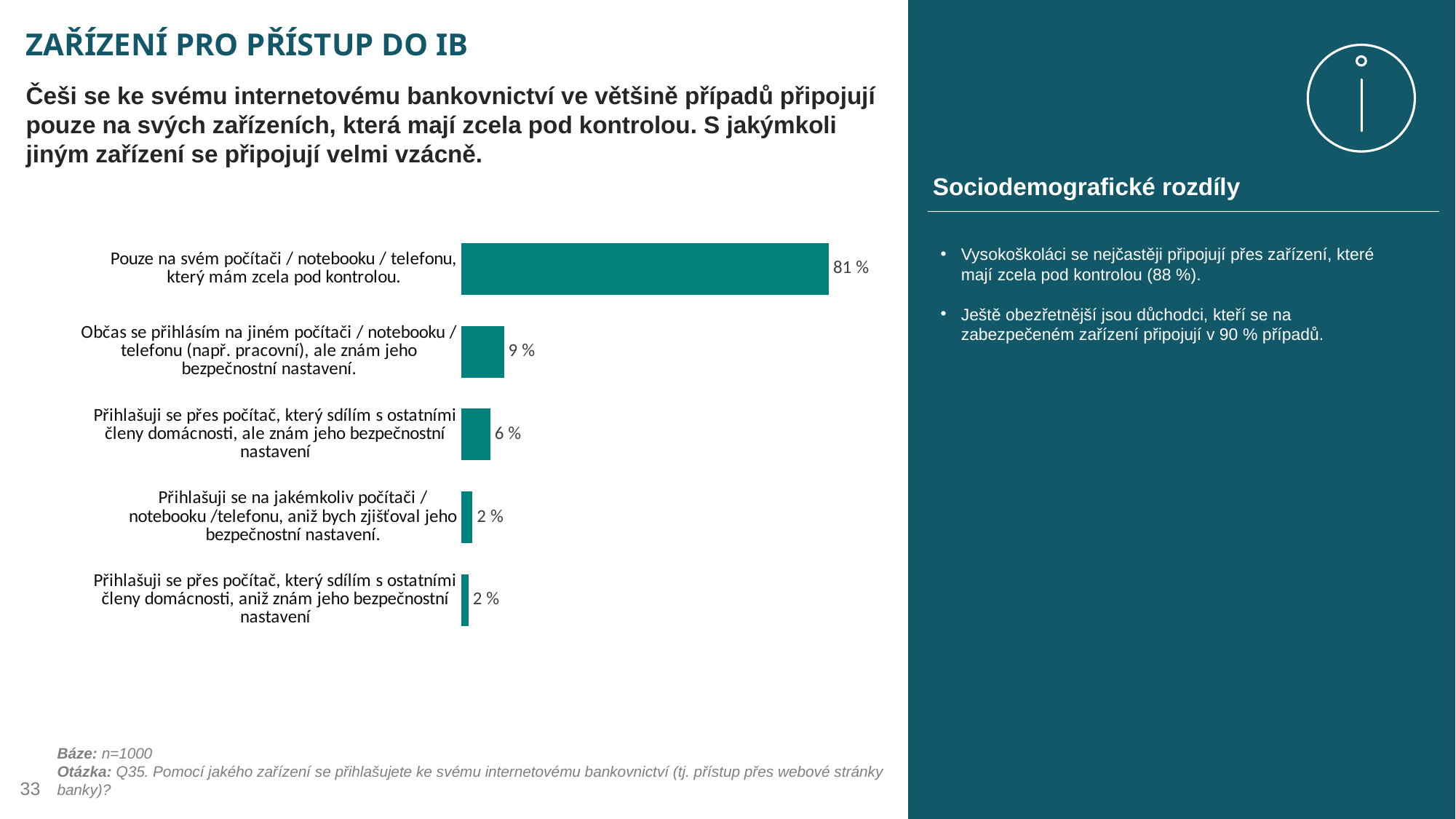
What is the value for "Přihlašuji se na jakémkoliv počítači / notebooku /telefonu, aniž bych zjišťoval jeho bezpečnostní nastavení."? 2 % Which category has the highest value in the chart? Pouze na svém počítači / notebooku / telefonu, který mám zcela pod kontrolou. What is the value for "Pouze na svém počítači / notebooku / telefonu, který mám zcela pod kontrolou."? 81 % What is the difference between the value for "Pouze na svém počítači / notebooku / telefonu, který mám zcela pod kontrolou." and the value for "Občas se přihlásím na jiném počítači / notebooku / telefonu (např. pracovní), ale znám jeho bezpečnostní nastavení."? 72 % What is the value for "Přihlašuji se přes počítač, který sdílím s ostatními členy domácnosti, ale znám jeho bezpečnostní nastavení"? 6 % How many categories (bars) does the chart show? 5 What is the title of the slide containing the chart? ZAŘÍZENÍ PRO PŘÍSTUP DO IB What is the lowest value shown in the chart? 2 % How many categories in the chart have a value of 2 %? 2 Which is larger: the value for "Občas se přihlásím na jiném počítači / notebooku / telefonu (např. pracovní), ale znám jeho bezpečnostní nastavení." or the value for "Přihlašuji se přes počítač, který sdílím s ostatními členy domácnosti, ale znám jeho bezpečnostní nastavení"? Občas se přihlásím na jiném počítači / notebooku / telefonu (např. pracovní), ale znám jeho bezpečnostní nastavení. What is the value for "Občas se přihlásím na jiném počítači / notebooku / telefonu (např. pracovní), ale znám jeho bezpečnostní nastavení."? 9 % What kind of chart is shown on the slide? bar chart